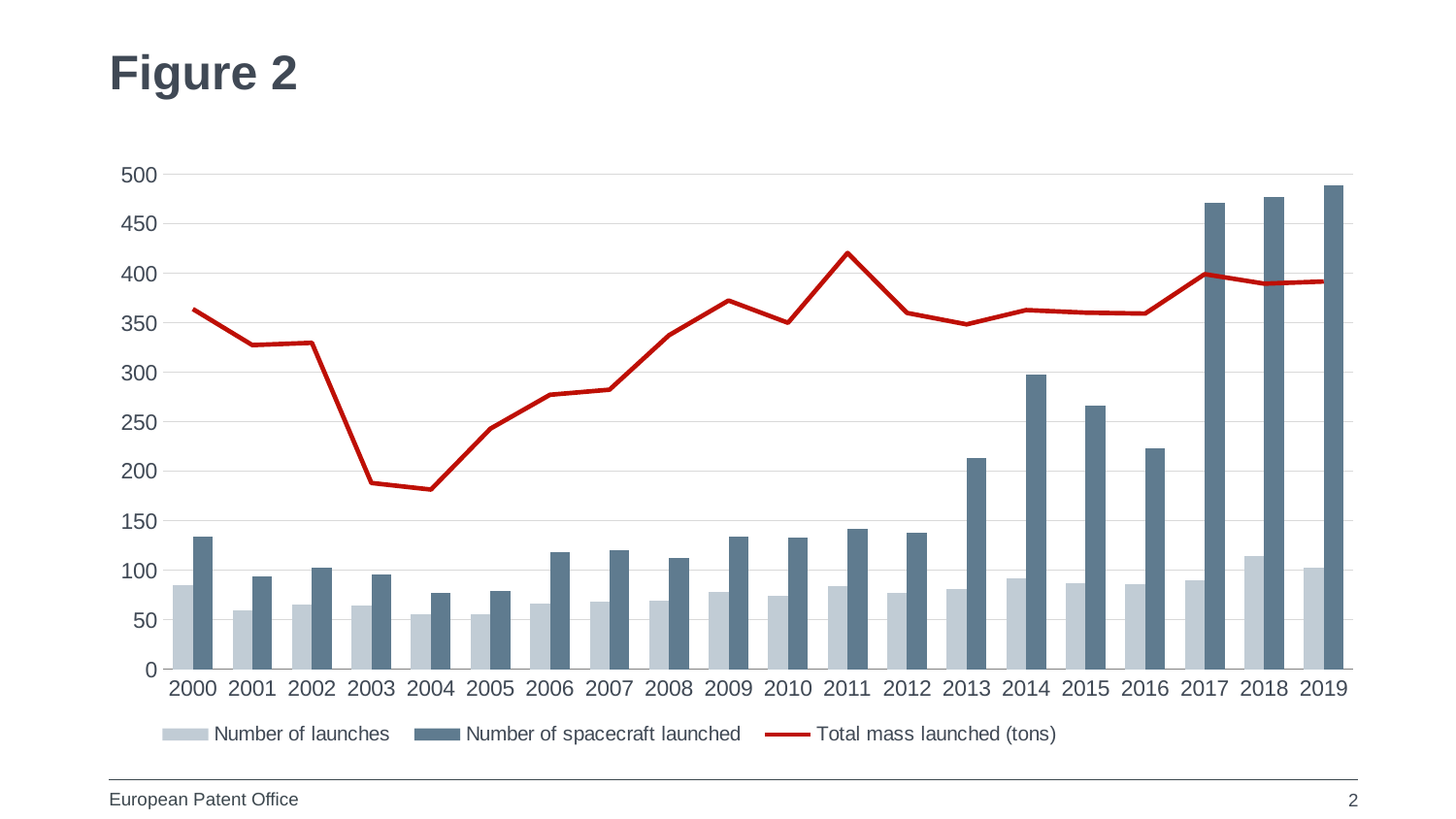
Does the number of spacecraft launched rise or fall from 2016 to 2019? rise In which year is the total mass launched (tons) highest? 2011 How many series does the legend list? 3 Is the number of launches in 2000 greater or less than 100? less In which year is the number of launches highest? 2018 Which year has a higher total mass launched (tons), 2000 or 2003? 2000 Which year has more spacecraft launched, 2016 or 2017? 2017 What kind of chart is this? Combined bar and line chart How many years are shown on the x axis? 20 Is the total mass launched (tons) in 2004 greater or less than 200? less Is the number of spacecraft launched in 2019 greater or less than 450? greater In which year is the number of spacecraft launched highest? 2019